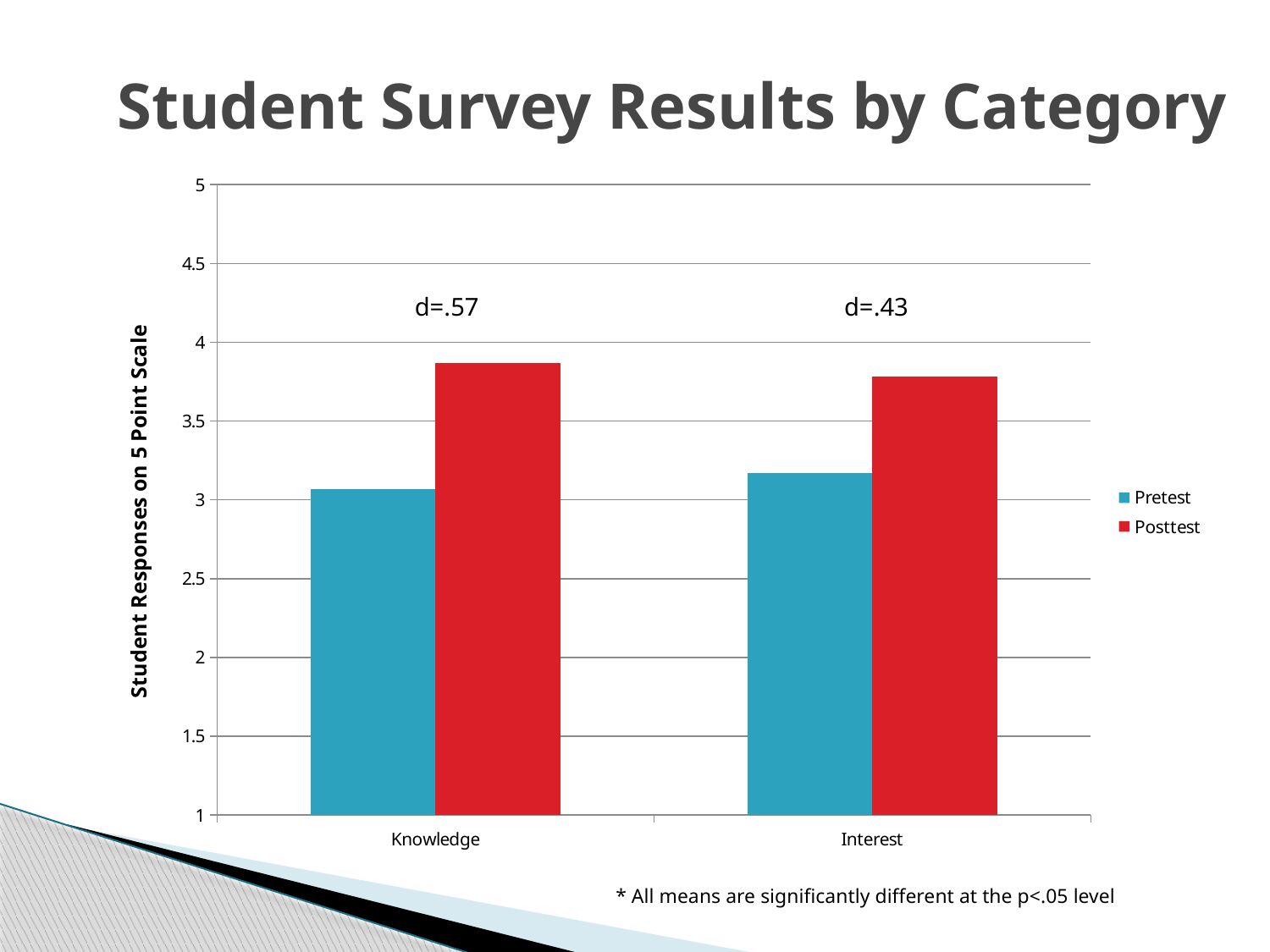
What effect size (d) is printed above the Interest bars? d=.43 Is the Posttest value for Interest greater or less than 4? less Is the Posttest value for Knowledge greater or less than 3.5? greater Which series has the higher value for Knowledge, Pretest or Posttest? Posttest Is the Pretest value for Knowledge greater or less than 3.5? less What effect size (d) is printed above the Knowledge bars? d=.57 What kind of chart is shown on the slide? bar chart How many categories are shown on the x axis? 2 How many series does the legend list? 2 Which bar is the shortest in the chart? Knowledge Pretest Which bar is the tallest in the chart? Knowledge Posttest Which series has the higher value for Interest, Pretest or Posttest? Posttest